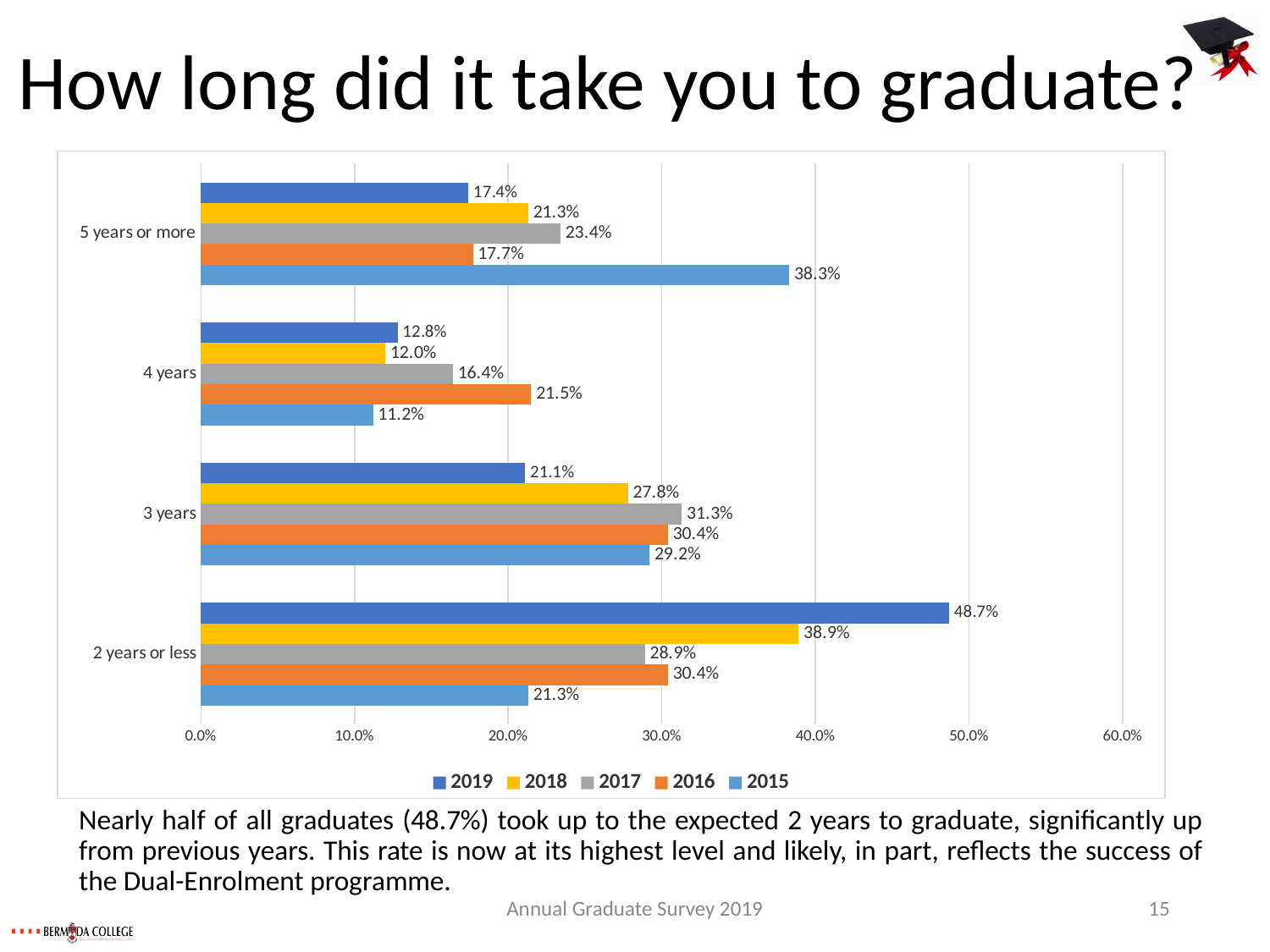
Which category has the lowest 2015 value? 4 years How many series does the legend list? 5 What is the 2019 value for '2 years or less'? 48.7% Which is larger for '5 years or more': the 2017 value or the 2016 value? 2017 What is the 2015 value for '5 years or more'? 38.3% Which category has the highest 2019 value? 2 years or less What kind of chart is shown on the slide? bar chart How many categories are shown on the y axis? 4 Is the 2019 value for '2 years or less' greater or less than 40.0%? greater What is the 2017 value for '3 years'? 31.3% What is the difference between the 2019 and 2018 values for '2 years or less'? 9.8% What is the 2016 value for '4 years'? 21.5%